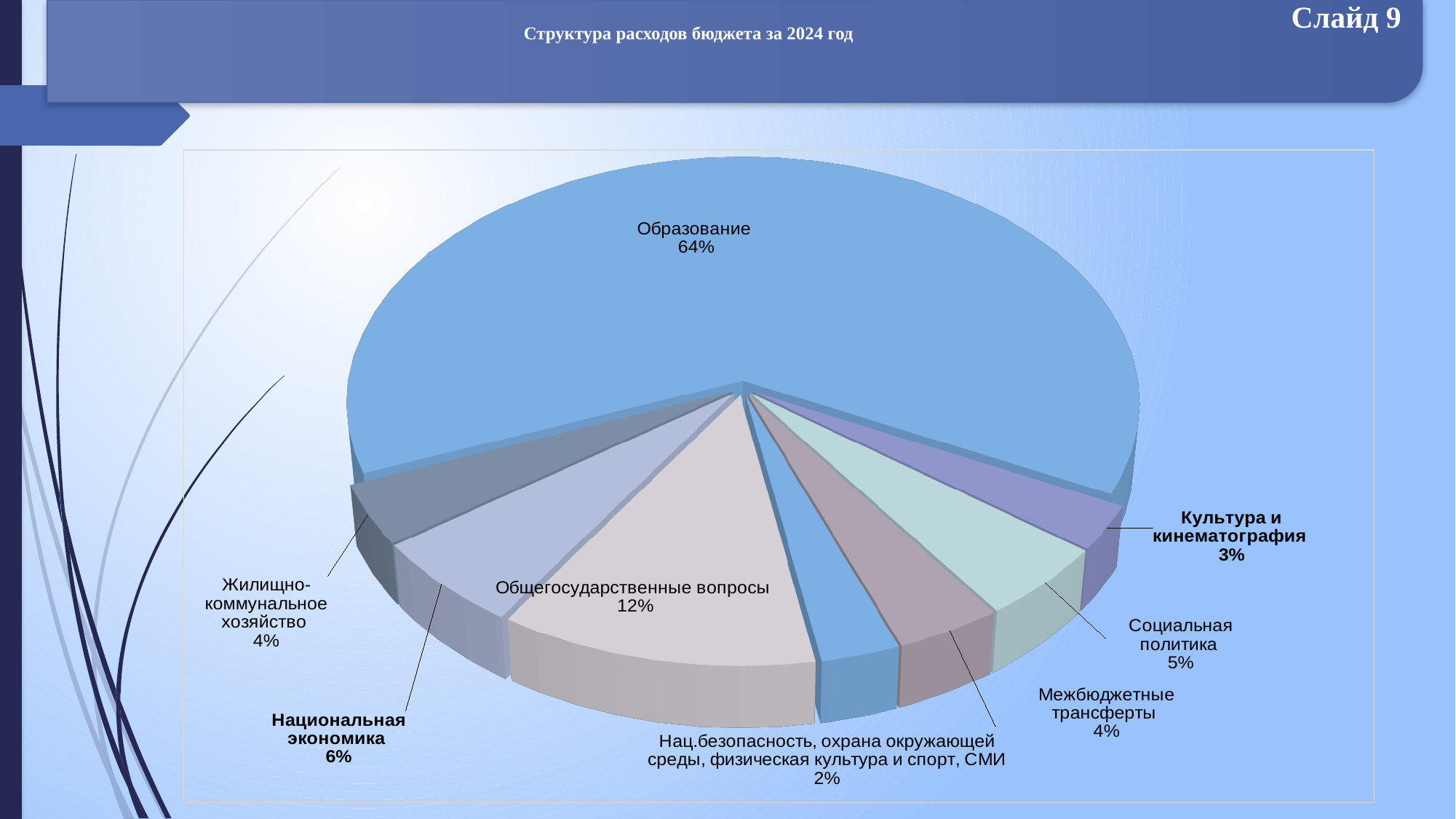
Which category has the smallest share of the pie? Нац.безопасность, охрана окружающей среды, физическая культура и спорт, СМИ What type of chart is shown on the slide? Pie chart What percentage is shown for Культура и кинематография? 3% What is the difference in percentage points between Образование and Общегосударственные вопросы? 52 What is the combined share of Жилищно-коммунальное хозяйство and Межбюджетные трансферты? 8% What is the title of the chart on the slide? Структура расходов бюджета за 2024 год Which category has the largest share of the pie? Образование How many categories (slices) does the pie chart have? 8 What percentage is shown for Общегосударственные вопросы? 12% What percentage is shown for Национальная экономика? 6% Which is larger: the share for Социальная политика or the share for Межбюджетные трансферты? Социальная политика What share of the budget expenditure goes to Образование? 64%